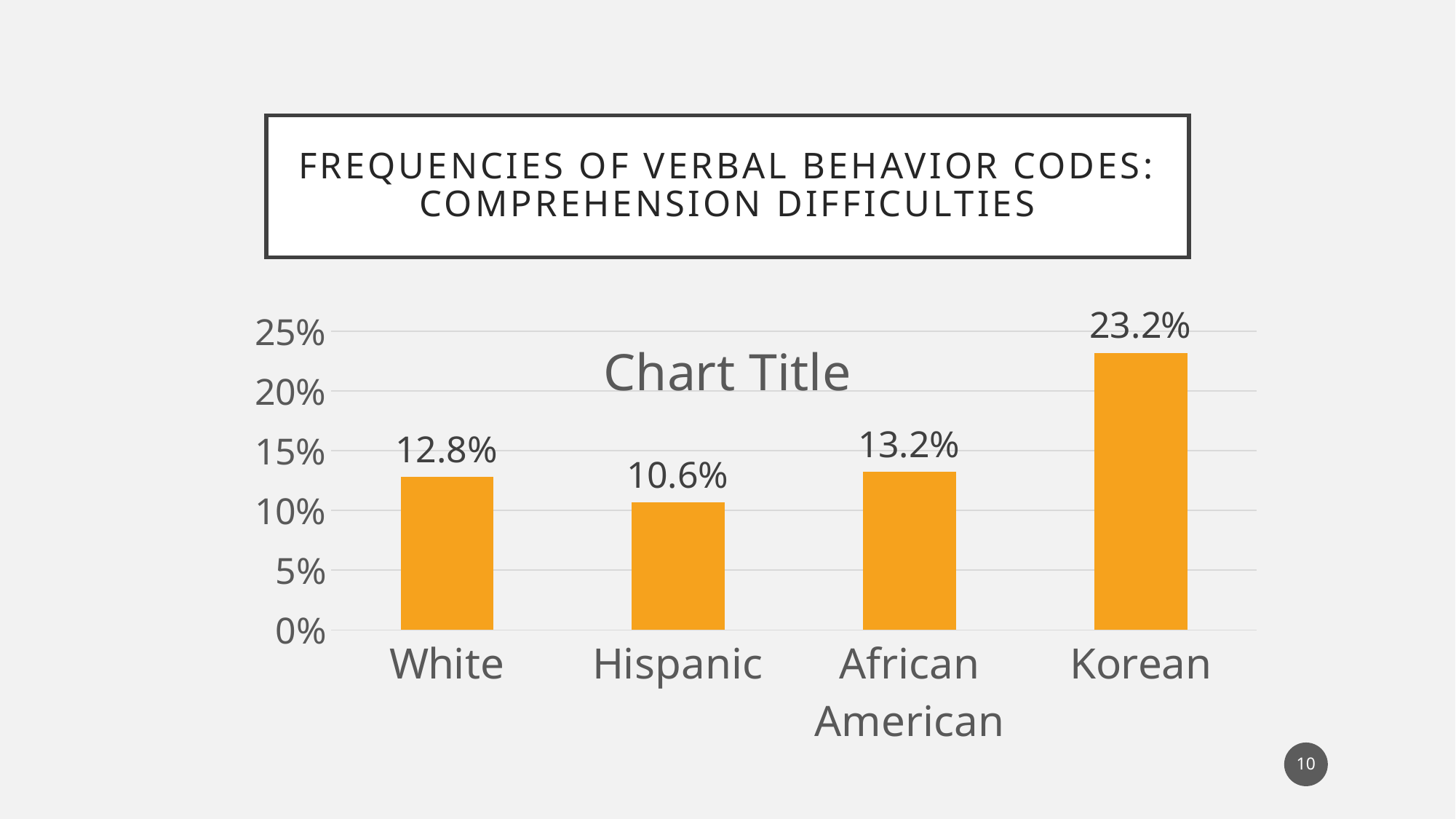
What is the value for Hispanic? 10.6% What is the difference between the values for African American and White? 0.4% What is the value for Korean? 23.2% How many categories are shown on the x axis? 4 Which category has the highest value? Korean What is the difference between the values for Korean and Hispanic? 12.6% Is the value for Korean greater or less than 20%? greater What is the value for White? 12.8% Which is larger, the value for Korean or the value for White? Korean Which category has the lowest value? Hispanic What kind of chart is shown on the slide? bar chart What is the value for African American? 13.2%